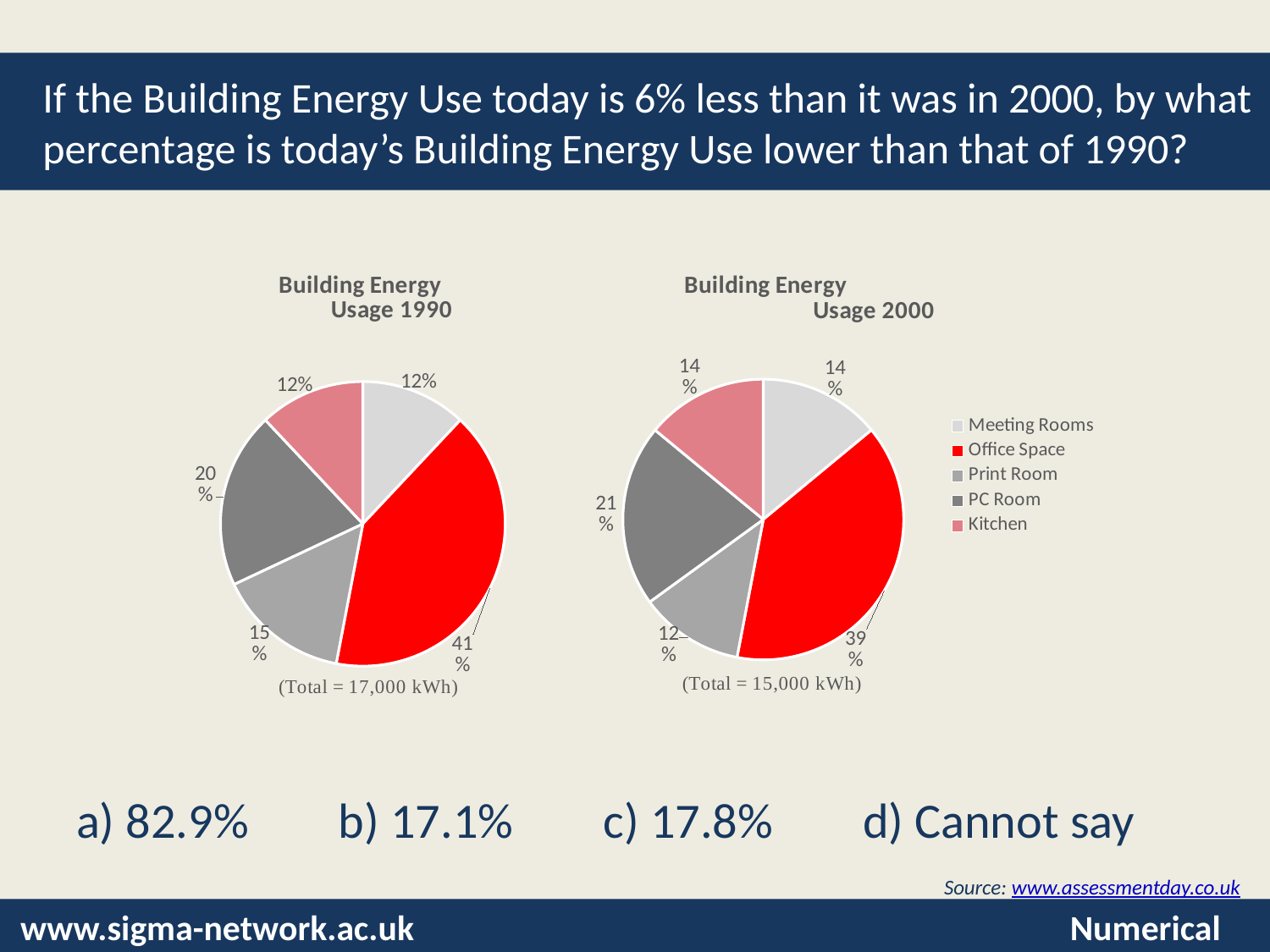
In the Building Energy Usage 1990 chart, what share does PC Room have? 20% In the Building Energy Usage 2000 chart, what share does Office Space have? 39% In the Building Energy Usage 1990 chart, what share does Office Space have? 41% What type of chart is the Building Energy Usage 1990 chart? Pie chart In the Building Energy Usage 1990 chart, what is the difference in percentage points between Office Space and PC Room? 21 How many categories does the legend list? 5 In the Building Energy Usage 2000 chart, which category has the largest slice? Office Space In the Building Energy Usage 2000 chart, which category has the smallest slice? Print Room In the Building Energy Usage 1990 chart, which category has the largest slice? Office Space What total is stated below the Building Energy Usage 2000 chart? 15,000 kWh In the Building Energy Usage 2000 chart, which is larger, the PC Room slice or the Kitchen slice? PC Room